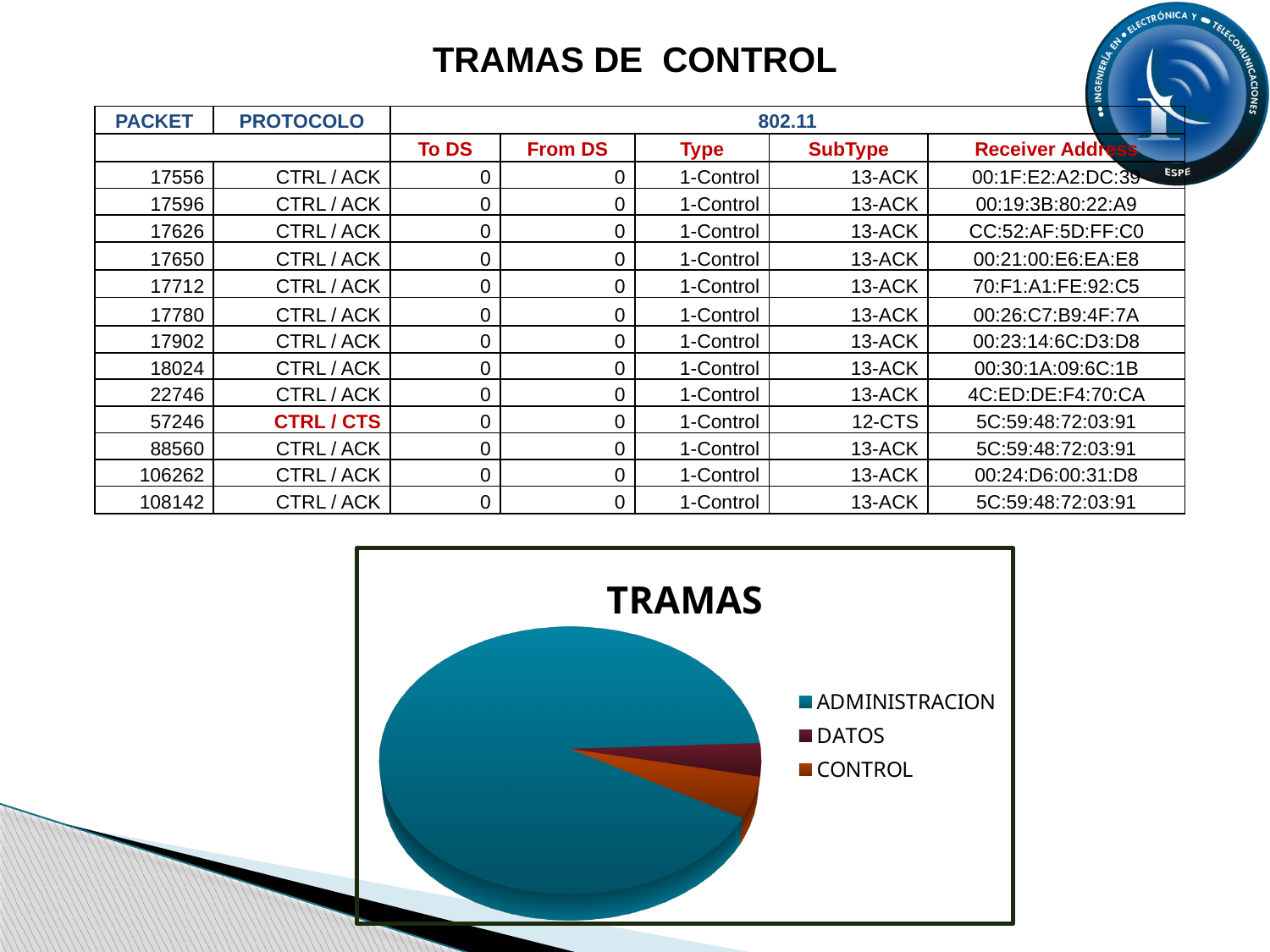
Which category has the largest slice in the pie chart? ADMINISTRACION What is the title of the chart on the slide? TRAMAS How many entries does the chart's legend list? 3 How many categories does the pie chart show? 3 Which slice is larger in the pie chart, ADMINISTRACION or DATOS? ADMINISTRACION Which slice is larger in the pie chart, ADMINISTRACION or CONTROL? ADMINISTRACION What colour is the ADMINISTRACION slice in the pie chart? Blue What kind of chart is shown on the slide? Pie chart